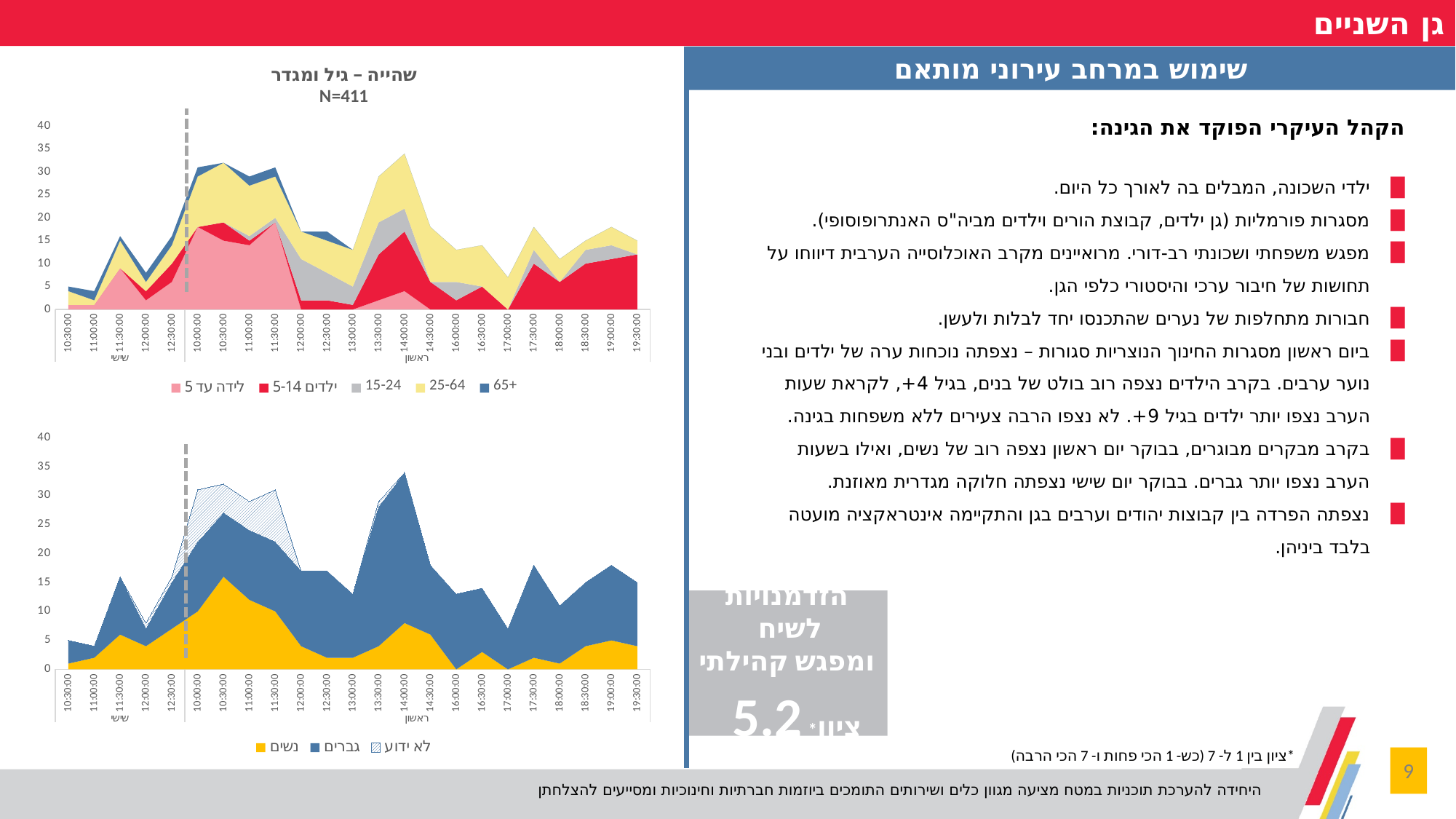
What kind of chart is the bottom chart on the slide? Stacked area chart In the bottom chart, is the total value at 17:00:00 on ראשון greater or less than 10? less In the top chart, at which time point is the total value highest? 14:00:00 (ראשון) In the top chart, which series is shown in yellow? 25-64 How many time points are plotted along the x axis of the bottom chart? 23 In the top chart, is the total value at 17:00:00 on ראשון greater or less than 5? less How many series does the legend of the bottom chart list? 3 What is the sample size (N) shown in the title of the top chart? N=411 What kind of chart is the top chart titled 'שהייה – גיל ומגדר'? Stacked area chart In the bottom chart, is the total value at 14:00:00 on ראשון greater or less than 30? greater How many series does the legend of the top chart list? 5